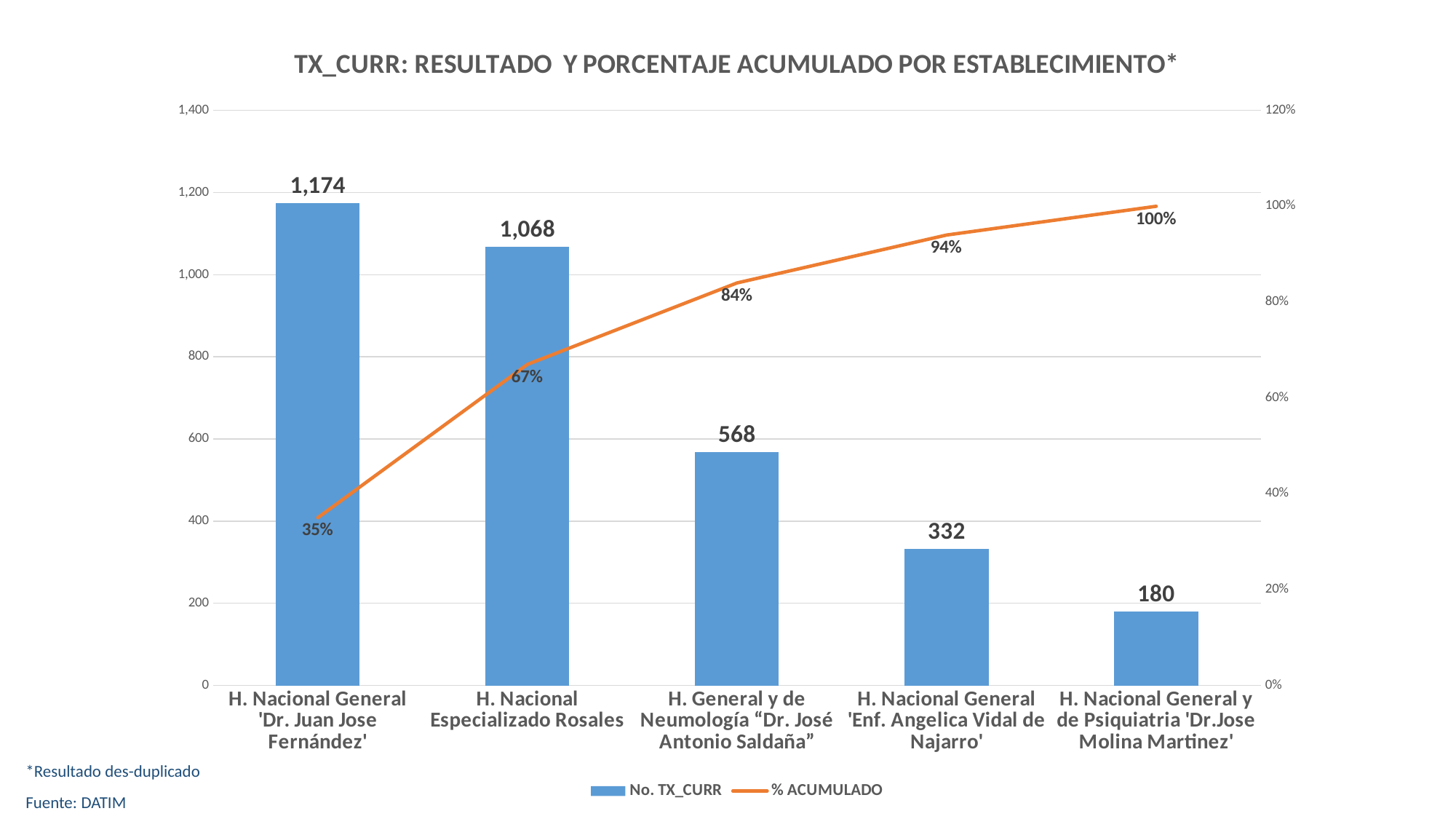
Which has a larger No. TX_CURR value: H. Nacional General 'Enf. Angelica Vidal de Najarro' or H. Nacional General y de Psiquiatria 'Dr.Jose Molina Martinez'? H. Nacional General 'Enf. Angelica Vidal de Najarro' What is the difference in No. TX_CURR between H. Nacional General 'Dr. Juan Jose Fernández' and H. Nacional Especializado Rosales? 106 What is the % ACUMULADO value at H. Nacional Especializado Rosales? 67% Which establishment has the lowest No. TX_CURR value? H. Nacional General y de Psiquiatria 'Dr.Jose Molina Martinez' How many series does the legend list? 2 What is the source cited at the bottom of the slide? DATIM What is the No. TX_CURR value for H. General y de Neumología "Dr. José Antonio Saldaña"? 568 How many establishments are shown on the x axis? 5 Which establishment has the highest No. TX_CURR value? H. Nacional General 'Dr. Juan Jose Fernández' What is the No. TX_CURR value for H. Nacional General 'Dr. Juan Jose Fernández'? 1,174 What is the % ACUMULADO value at H. Nacional General 'Enf. Angelica Vidal de Najarro'? 94% Do the No. TX_CURR bar values rise or fall from left to right along the x axis? fall